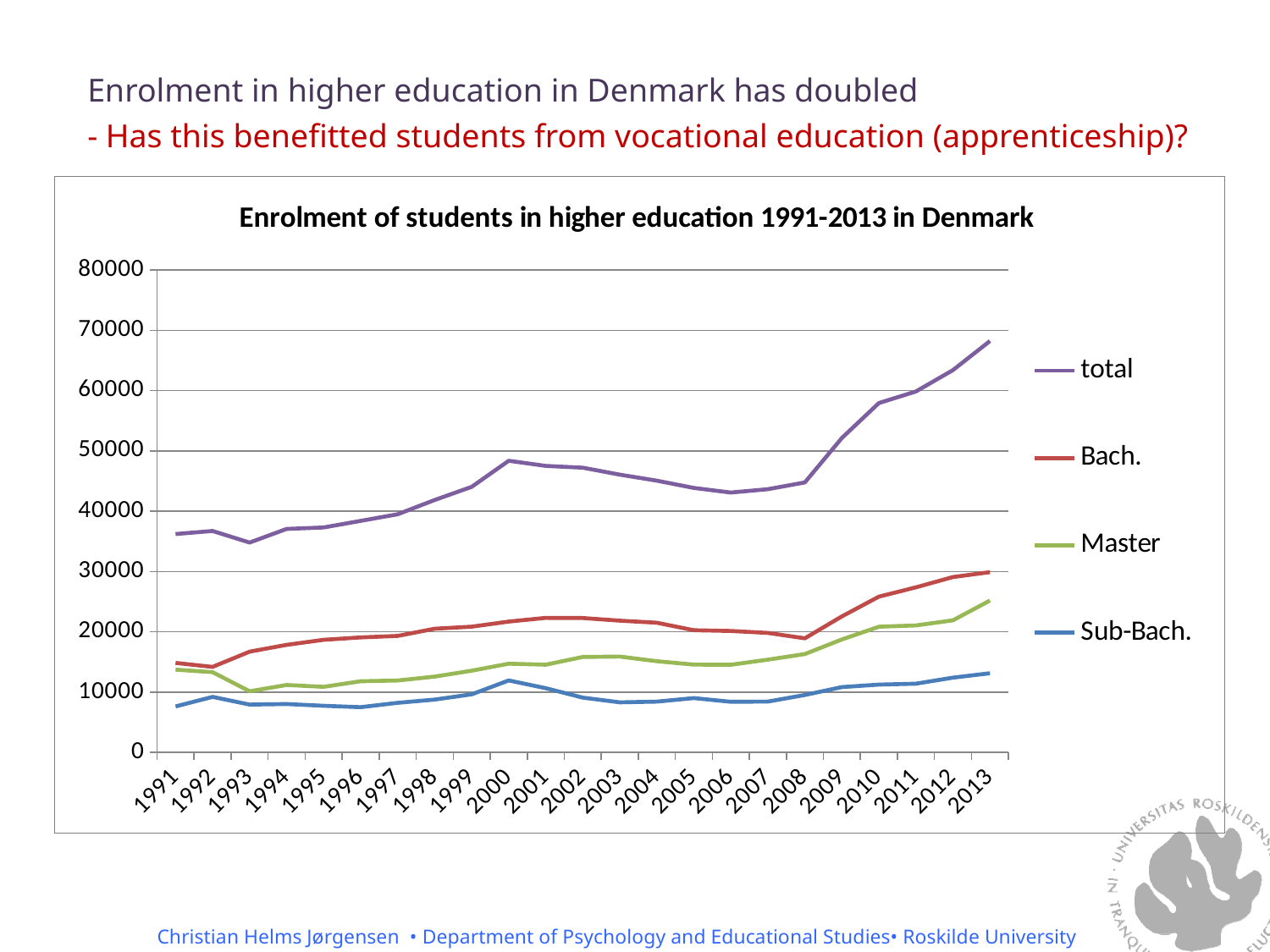
Is the value for total in 1991 greater or less than 40000? less How many series does the legend list? 4 Which series has the highest value in 2013? total What kind of chart is shown on the slide? line chart Is the value for Bach. in 2013 greater or less than 20000? greater What is the title of the chart? Enrolment of students in higher education 1991-2013 in Denmark In 2013, which is larger: Bach. or Master? Bach. Is the value for total in 2013 greater or less than 60000? greater Which series has the lowest value in 2013? Sub-Bach. Does the total series rise or fall from 2008 to 2013? rise How many years are plotted along the x axis? 23